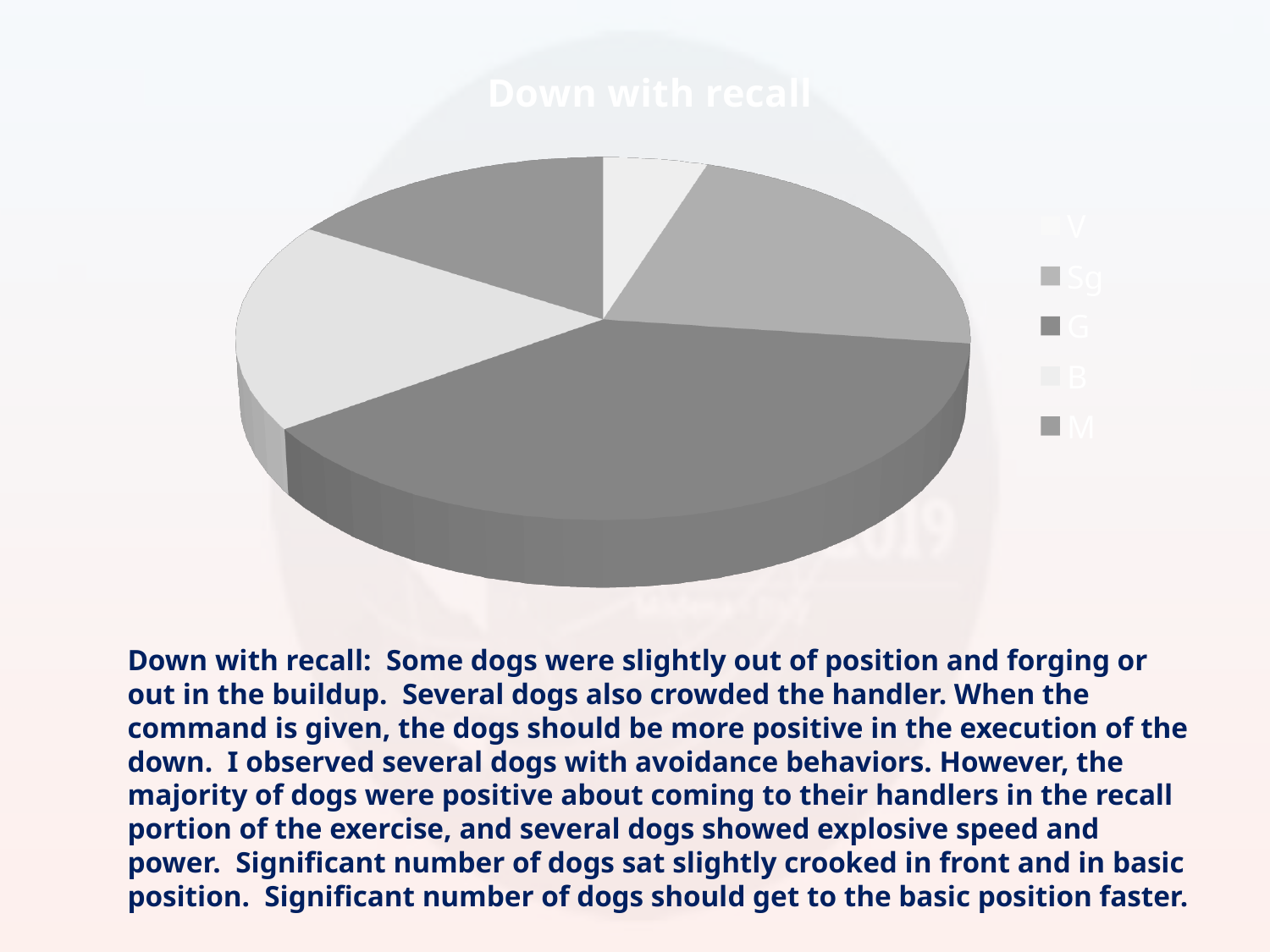
Which slice is larger, Sg or V? Sg What is the title of the chart? Down with recall Which category has the largest slice of the pie chart? G Which category has the smallest slice of the pie chart? V Which slice is larger, B or V? B How many categories does the legend of the pie chart list? 5 What kind of chart is shown on the slide? pie chart Which slice is larger, G or Sg? G Which categories are listed in the legend of the pie chart? V, Sg, G, B, M